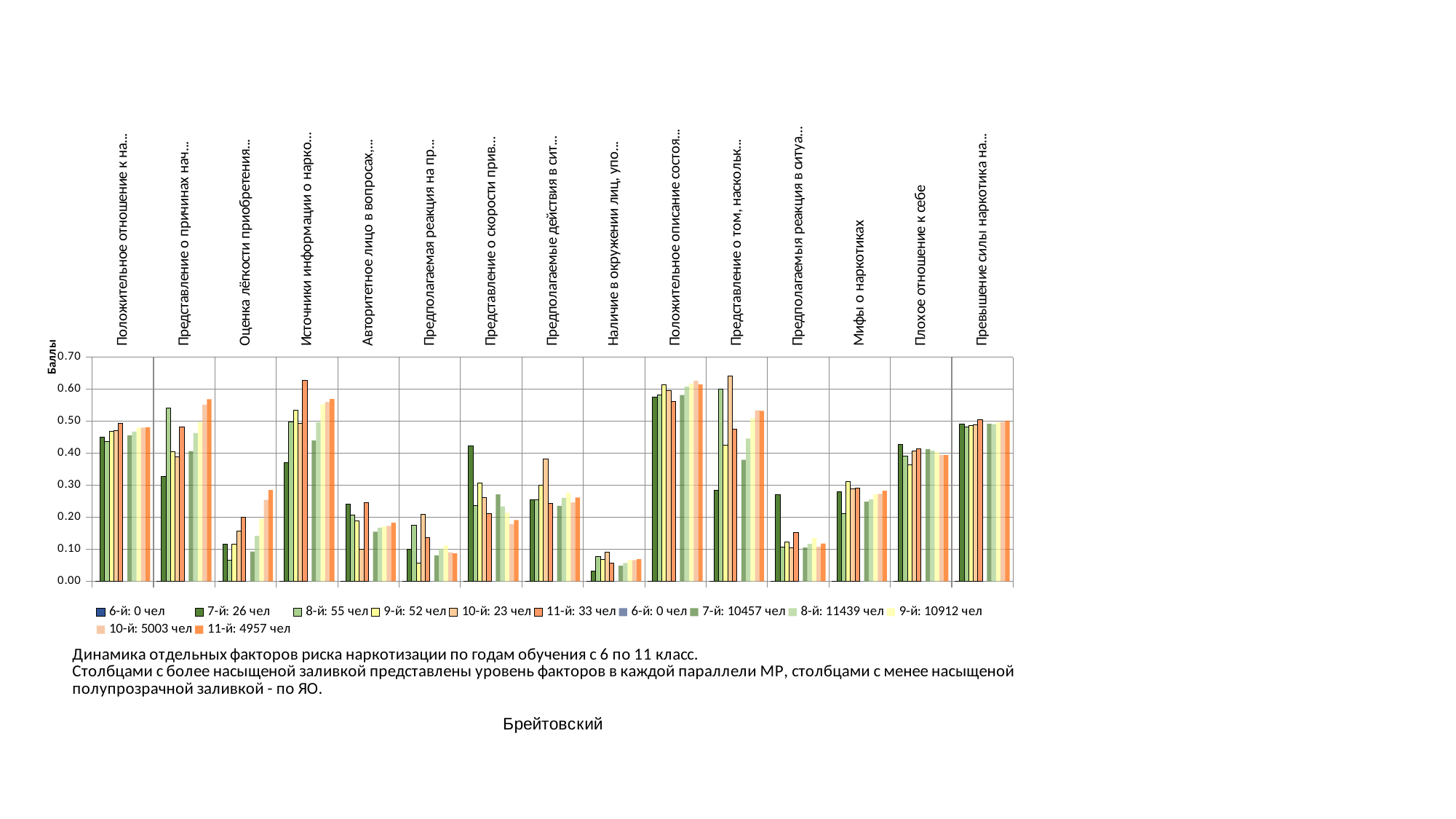
In the category "Мифы о наркотиках", which is larger: the value for "7-й: 26 чел" or for "8-й: 55 чел"? 7-й: 26 чел Is the value for "9-й: 52 чел" in the category "Мифы о наркотиках" greater or less than 0.20? greater What kind of chart is shown on the slide? bar chart How many series does the legend list? 12 In the category "Плохое отношение к себе", which is larger: the value for "7-й: 26 чел" or for "9-й: 52 чел"? 7-й: 26 чел Is the value for "11-й: 33 чел" in the category "Плохое отношение к себе" greater or less than 0.30? greater How many categories are plotted along the x axis? 15 Is the value for "7-й: 26 чел" in the category "Плохое отношение к себе" greater or less than 0.30? greater What is the highest tick value shown on the vertical axis? 0.70 What is the title of the vertical axis? Баллы